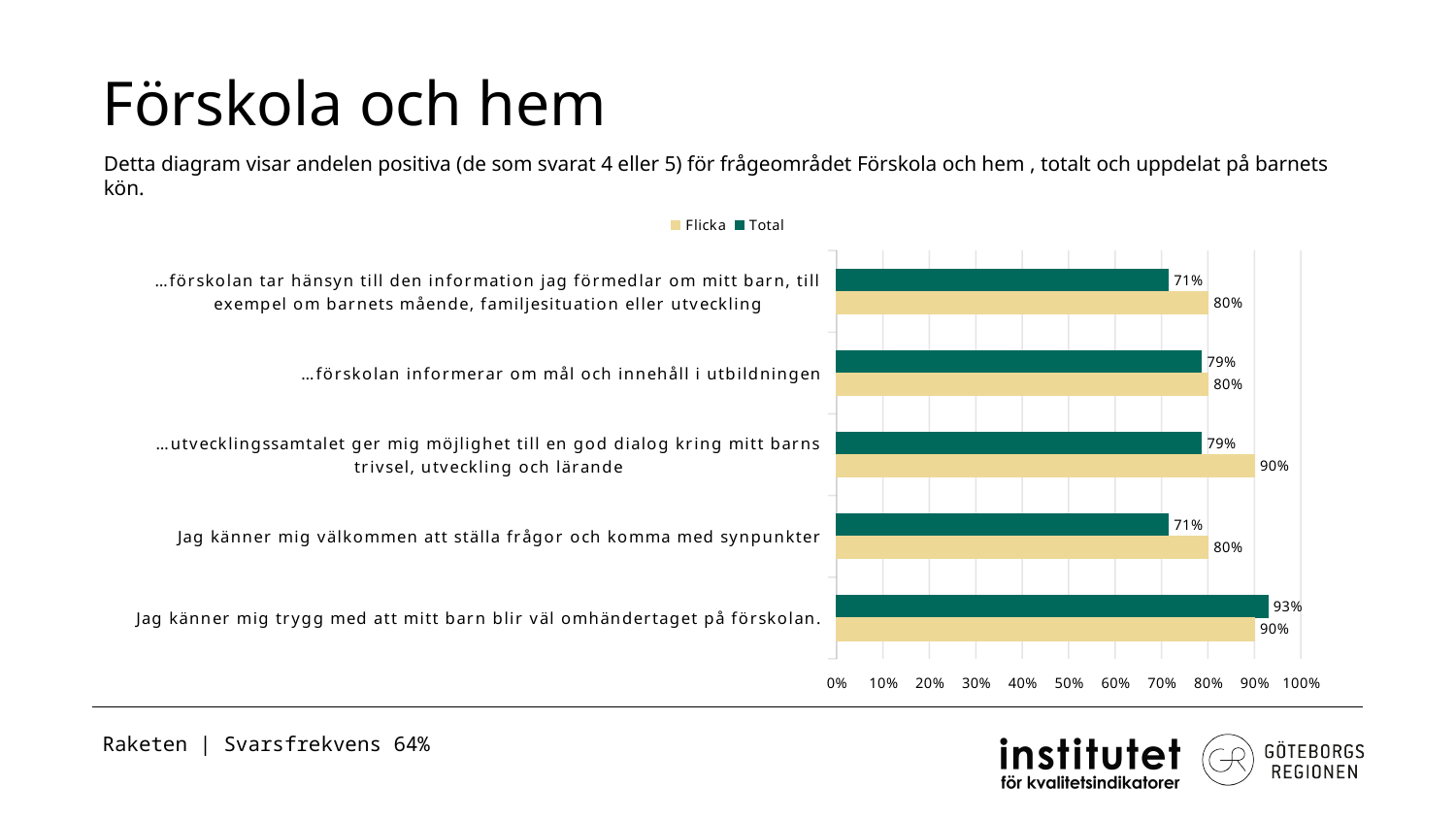
What is the Total value for "Jag känner mig välkommen att ställa frågor och komma med synpunkter"? 71% How many statements (categories) are plotted in the chart? 5 What is the difference between the Flicka and Total values for "…utvecklingssamtalet ger mig möjlighet till en god dialog kring mitt barns trivsel, utveckling och lärande"? 11% What is the Flicka value for "…utvecklingssamtalet ger mig möjlighet till en god dialog kring mitt barns trivsel, utveckling och lärande"? 90% Which series is shown in dark green in the legend? Total What is the difference between the Flicka and Total values for "…förskolan tar hänsyn till den information jag förmedlar om mitt barn, till exempel om barnets mående, familjesituation eller utveckling"? 9% What is the Flicka value for "…förskolan informerar om mål och innehåll i utbildningen"? 80% Which statement has the highest Total value? Jag känner mig trygg med att mitt barn blir väl omhändertaget på förskolan. What kind of chart is shown on the slide? bar chart What is the Total value for "Jag känner mig trygg med att mitt barn blir väl omhändertaget på förskolan."? 93% For "Jag känner mig trygg med att mitt barn blir väl omhändertaget på förskolan.", which is larger: the Flicka value or the Total value? Total How many series does the legend list? 2